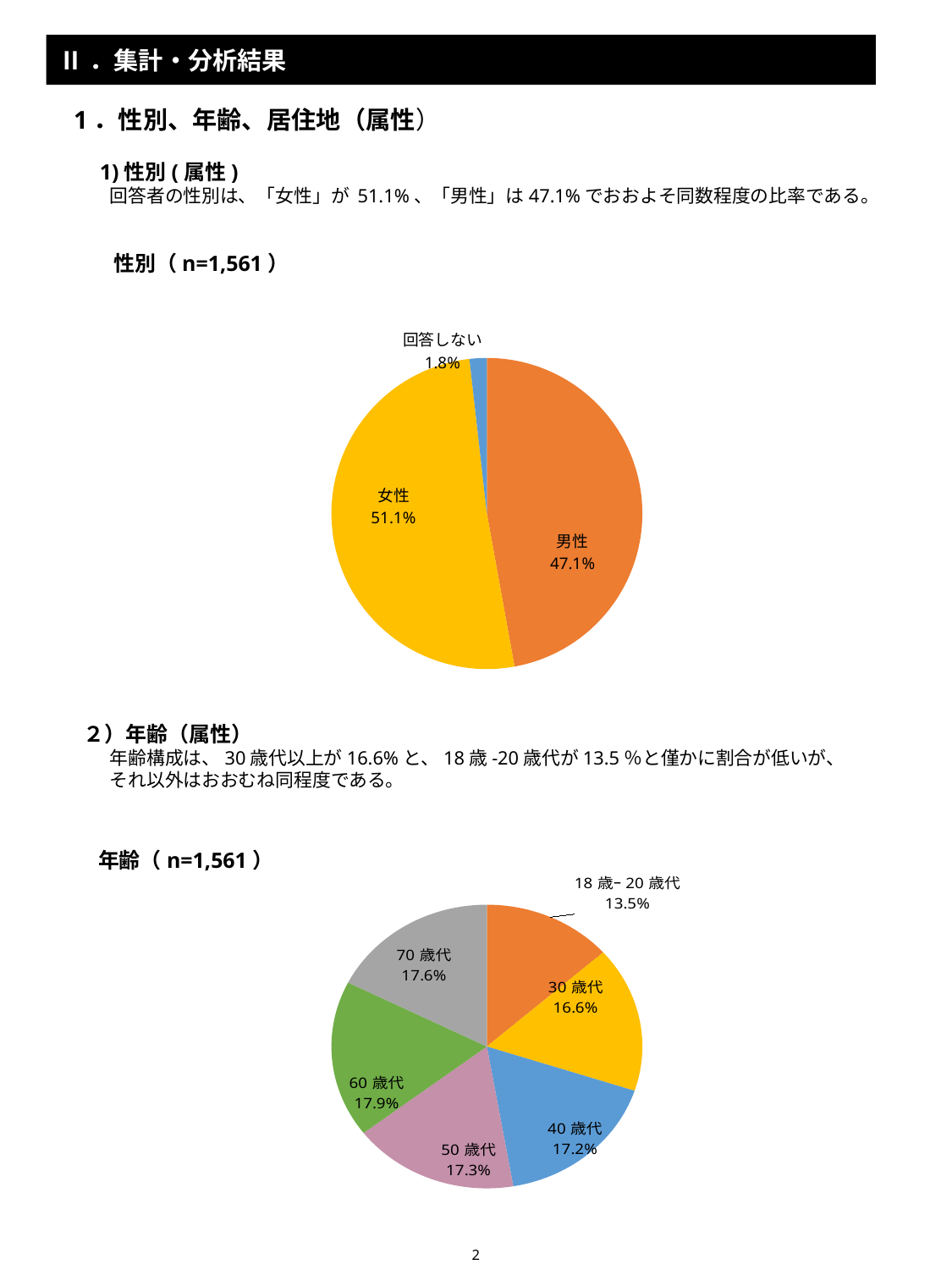
In the 年齢 (n=1,561) pie chart, how many age categories are shown? 6 In the 性別 (n=1,561) pie chart, what colour is the 男性 slice? Orange In the 性別 (n=1,561) pie chart, how many slices are there? 3 In the 性別 (n=1,561) pie chart, what share is labelled for 女性? 51.1% In the 性別 (n=1,561) pie chart, which category has the smallest slice? 回答しない In the 性別 (n=1,561) pie chart, what share is labelled for 回答しない? 1.8% In the 年齢 (n=1,561) pie chart, what share is labelled for 60 歳代? 17.9% What kind of chart is the 年齢 (n=1,561) chart? Pie chart In the 年齢 (n=1,561) pie chart, what share is labelled for 18 歳–20 歳代? 13.5% In the 年齢 (n=1,561) pie chart, which age group has the smallest slice? 18 歳–20 歳代 In the 年齢 (n=1,561) pie chart, what is the difference in percentage points between 70 歳代 and 30 歳代? 1.0 percentage point In the 性別 (n=1,561) pie chart, what is the difference in percentage points between 女性 and 男性? 4.0 percentage points